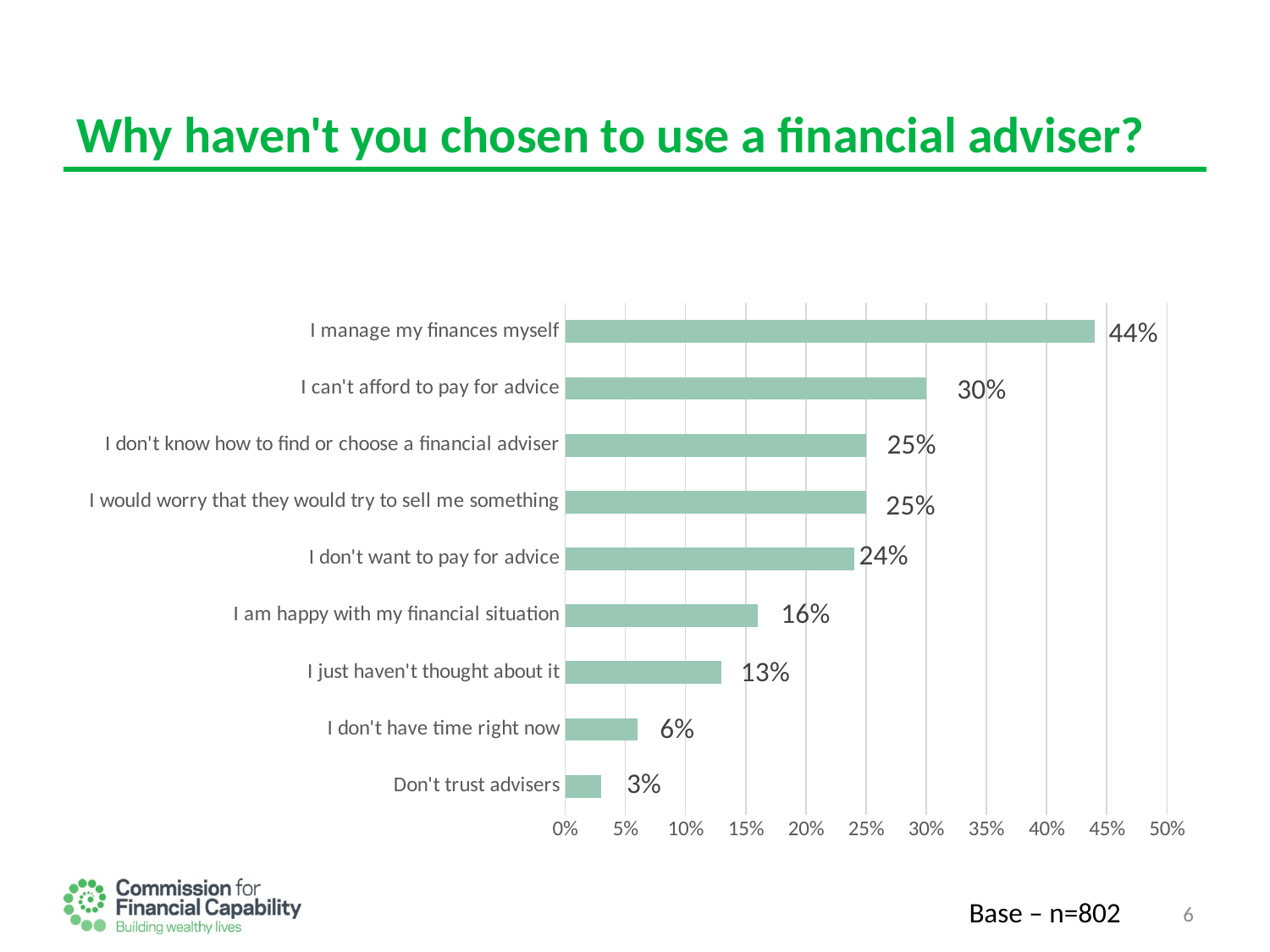
Is the value for "I don't want to pay for advice" greater or less than 20%? greater How many reasons are shown in the chart? 9 What kind of chart is shown on the slide? Bar chart Which is larger: "I am happy with my financial situation" or "I just haven't thought about it"? I am happy with my financial situation What is the difference between "I manage my finances myself" and "I can't afford to pay for advice"? 14% Which reason has the lowest percentage? Don't trust advisers What is the value for "I can't afford to pay for advice"? 30% Which reason has the highest percentage? I manage my finances myself What percentage of respondents said "I manage my finances myself"? 44% What percentage chose "I don't have time right now"? 6% What is the difference between "I don't have time right now" and "Don't trust advisers"? 3% What is the base sample size noted on the slide? n=802